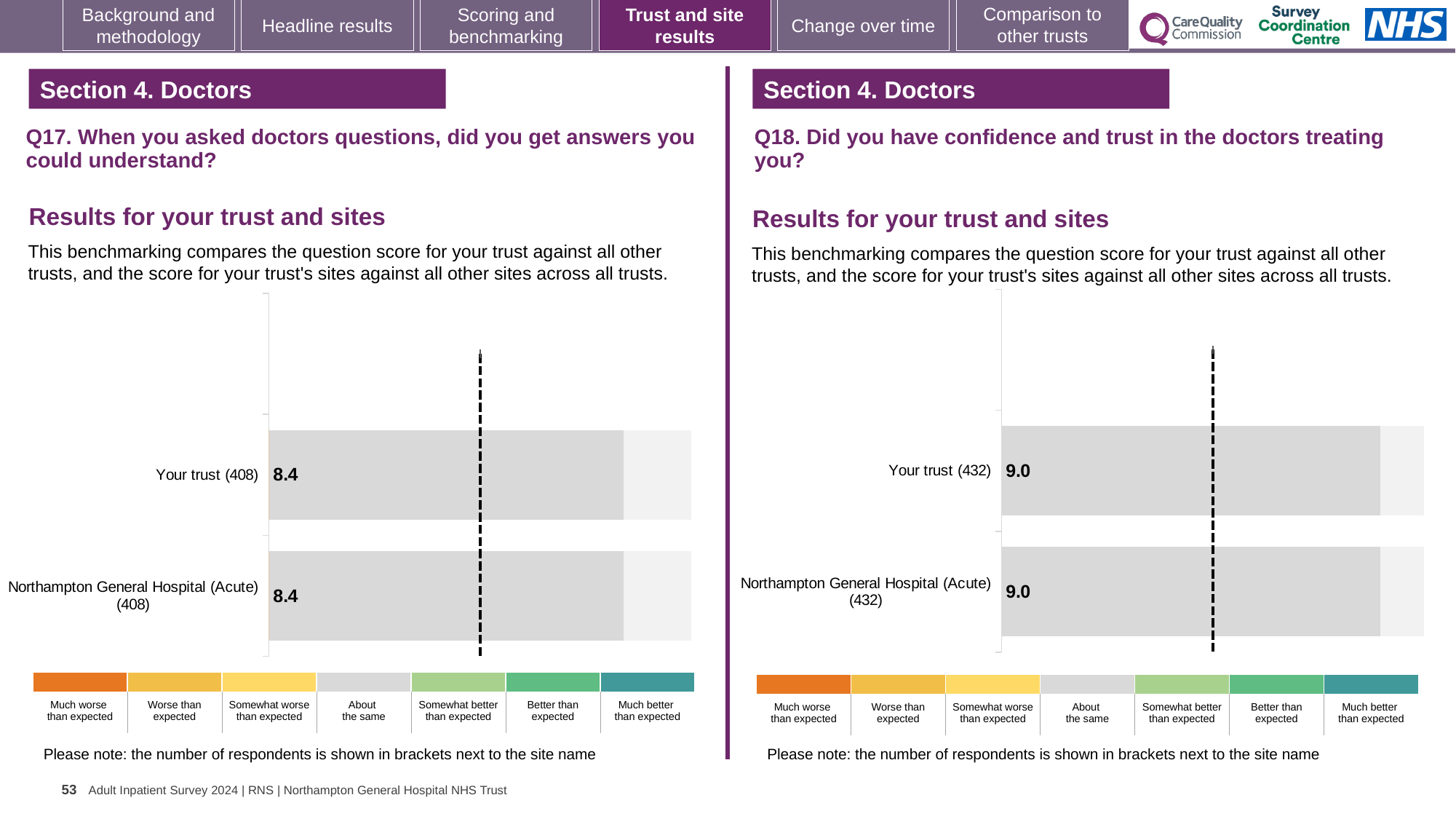
What kind of chart is used on the Q17 chart (left)? Bar chart How many bars are plotted on the Q17 chart (left)? 2 Is the score for Your trust on the Q18 chart (right) larger or smaller than the score for Your trust on the Q17 chart (left)? Larger How many bars are plotted on the Q18 chart (right)? 2 On the Q17 chart (left), what is the score for Your trust? 8.4 On the Q17 chart (left), what is the difference between the score for Your trust and the score for Northampton General Hospital (Acute)? 0.0 On the Q18 chart (right), what is the score for Northampton General Hospital (Acute)? 9.0 On the Q18 chart (right), how many respondents are shown in brackets for Northampton General Hospital (Acute)? 432 On the Q17 chart (left), what is the score for Northampton General Hospital (Acute)? 8.4 On the Q17 chart (left), how many respondents are shown in brackets for Your trust? 408 On the Q18 chart (right), what is the score for Your trust? 9.0 On the Q18 chart (right), what is the difference between the score for Your trust and the score for Northampton General Hospital (Acute)? 0.0